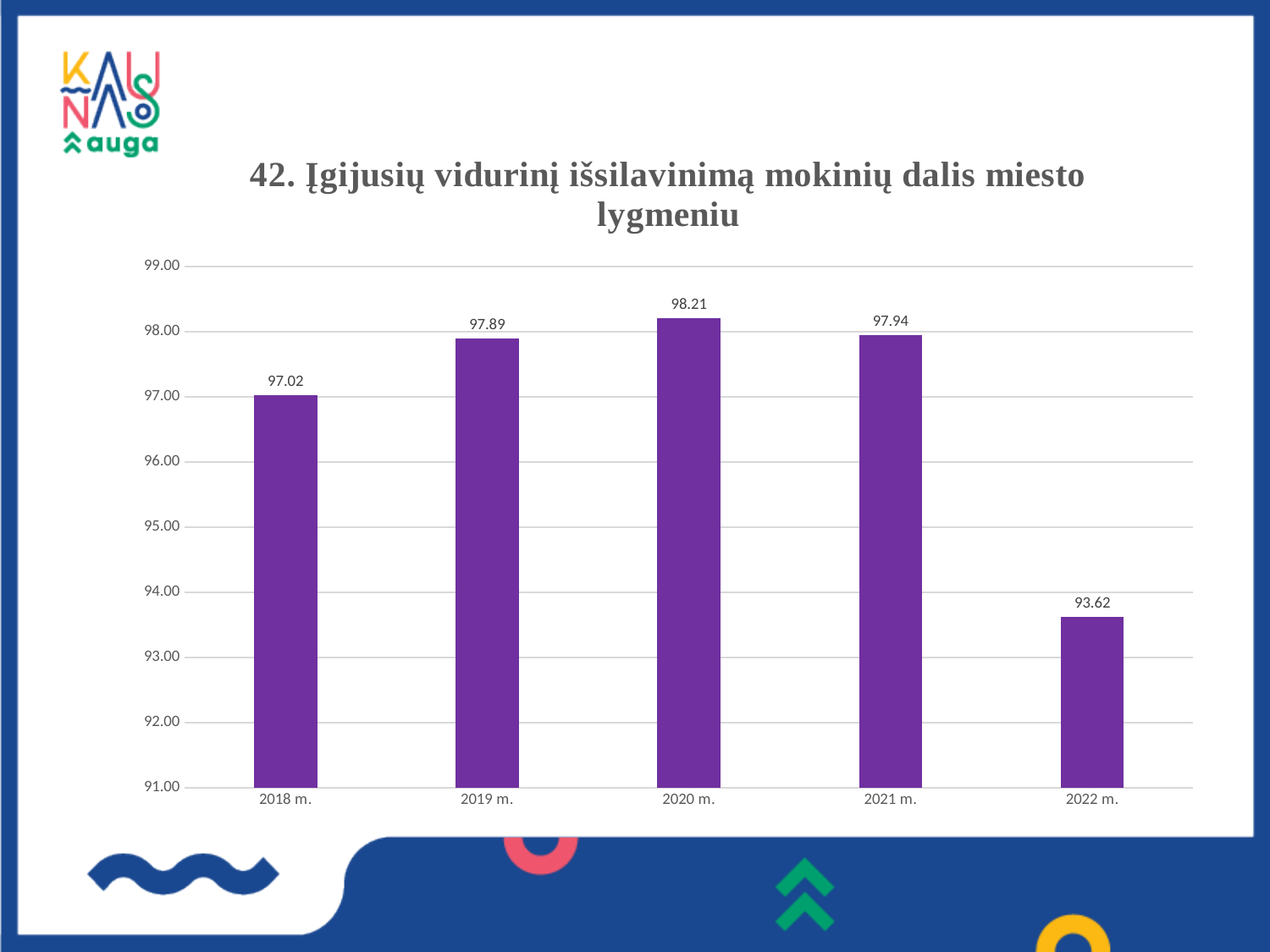
What is the title of the chart? 42. Įgijusių vidurinį išsilavinimą mokinių dalis miesto lygmeniu Which is larger, the value for 2019 m. or the value for 2021 m.? 2021 m. Which year has the lowest value? 2022 m. How many years are shown on the x axis? 5 Is the value for 2022 m. greater or less than 94.00? less What is the value for 2022 m.? 93.62 What is the value for 2020 m.? 98.21 What is the difference between the values for 2019 m. and 2018 m.? 0.87 What kind of chart is shown on the slide? bar chart Which year has the highest value? 2020 m. What is the value for 2018 m.? 97.02 What is the difference between the values for 2021 m. and 2022 m.? 4.32